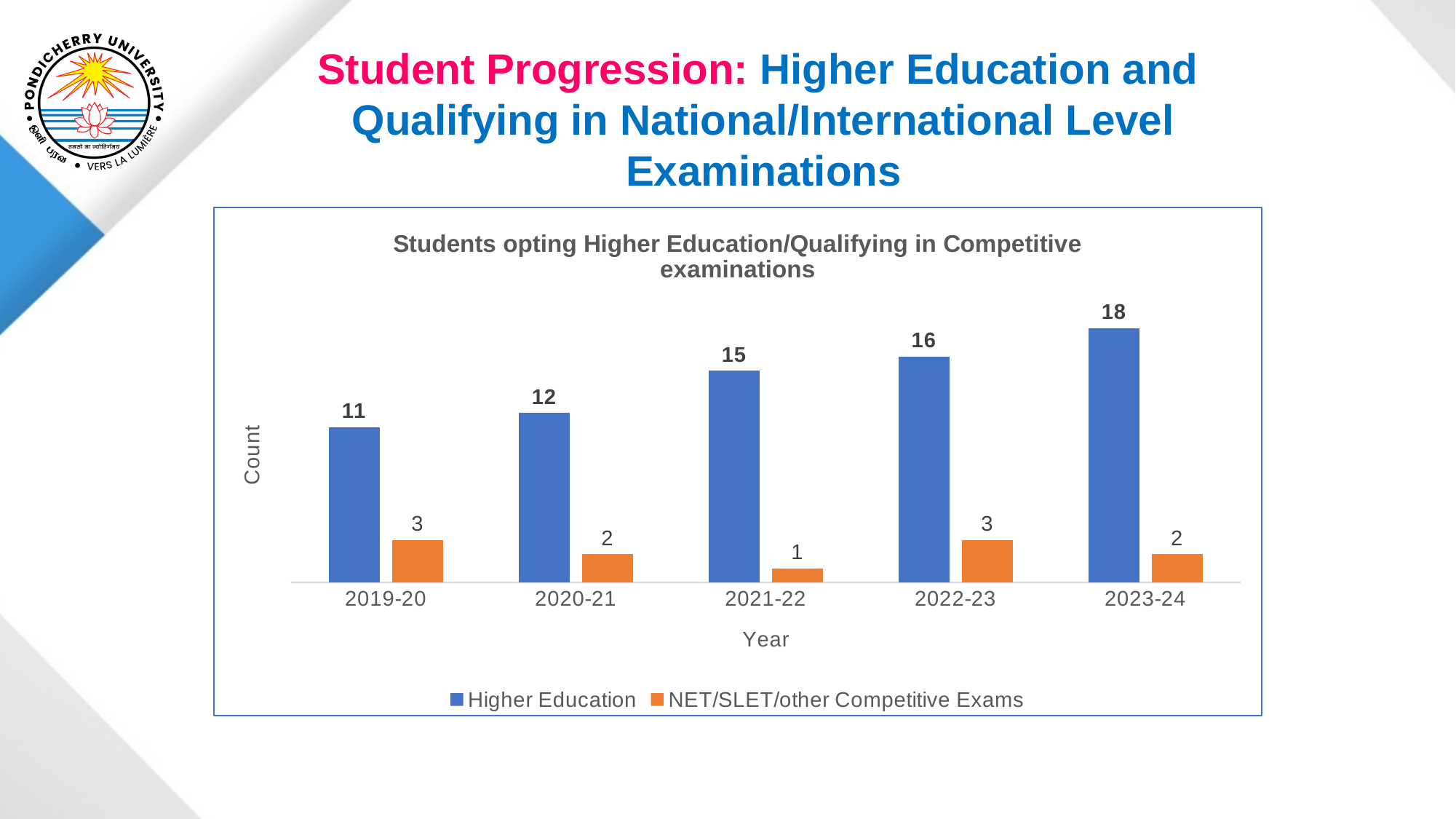
Which year has the highest Higher Education value? 2023-24 What is the Higher Education value for 2021-22? 15 What is the title of the chart? Students opting Higher Education/Qualifying in Competitive examinations What kind of chart is shown on the slide? Bar chart Which year has the lowest NET/SLET/other Competitive Exams value? 2021-22 What is the difference between the Higher Education values for 2023-24 and 2019-20? 7 What is the label of the y axis? Count Do the Higher Education values rise or fall from 2019-20 to 2023-24? Rise How many years are shown on the x axis? 5 Which is larger: the Higher Education value for 2020-21 or for 2022-23? 2022-23 What is the NET/SLET/other Competitive Exams value for 2020-21? 2 How many series does the legend list? 2